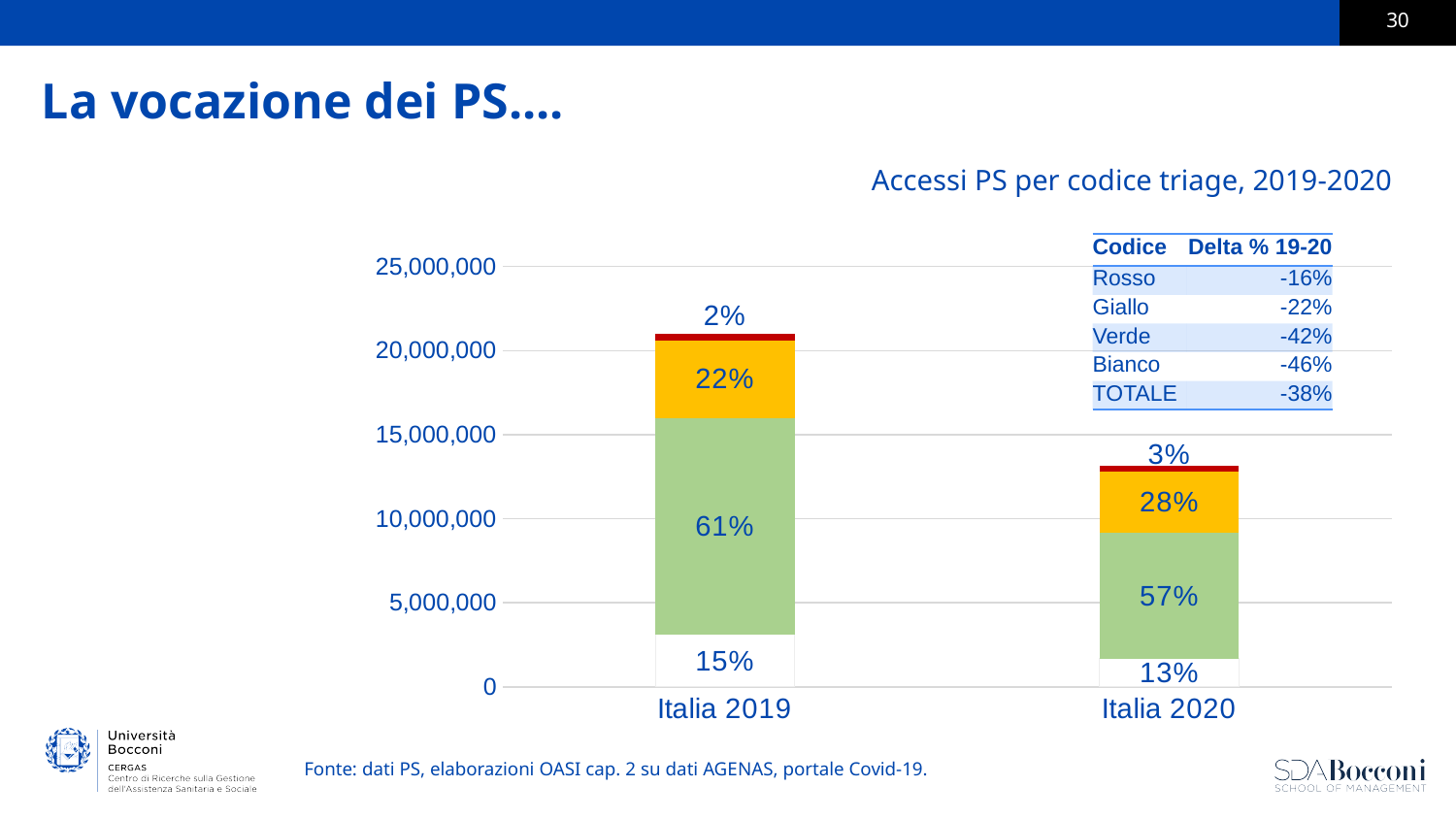
Is the total height of the Italia 2019 bar greater or less than 20,000,000? greater How many bars (categories) are plotted on the chart? 2 What kind of chart is shown on the slide? Stacked bar chart What percentage is shown at the bottom of the Italia 2020 bar? 13% Is the total height of the Italia 2020 bar greater or less than 15,000,000? less Does the total bar height rise or fall from Italia 2019 to Italia 2020? Fall What percentage is shown for the green segment of the Italia 2019 bar? 61% Which bar has the larger green segment share, Italia 2019 or Italia 2020? Italia 2019 What percentage is shown for the yellow segment of the Italia 2020 bar? 28% What percentage is shown for the red segment at the top of the Italia 2019 bar? 2% What is the title of the chart? Accessi PS per codice triage, 2019-2020 What is the difference in percentage points between the yellow segment shares of Italia 2020 and Italia 2019? 6 percentage points